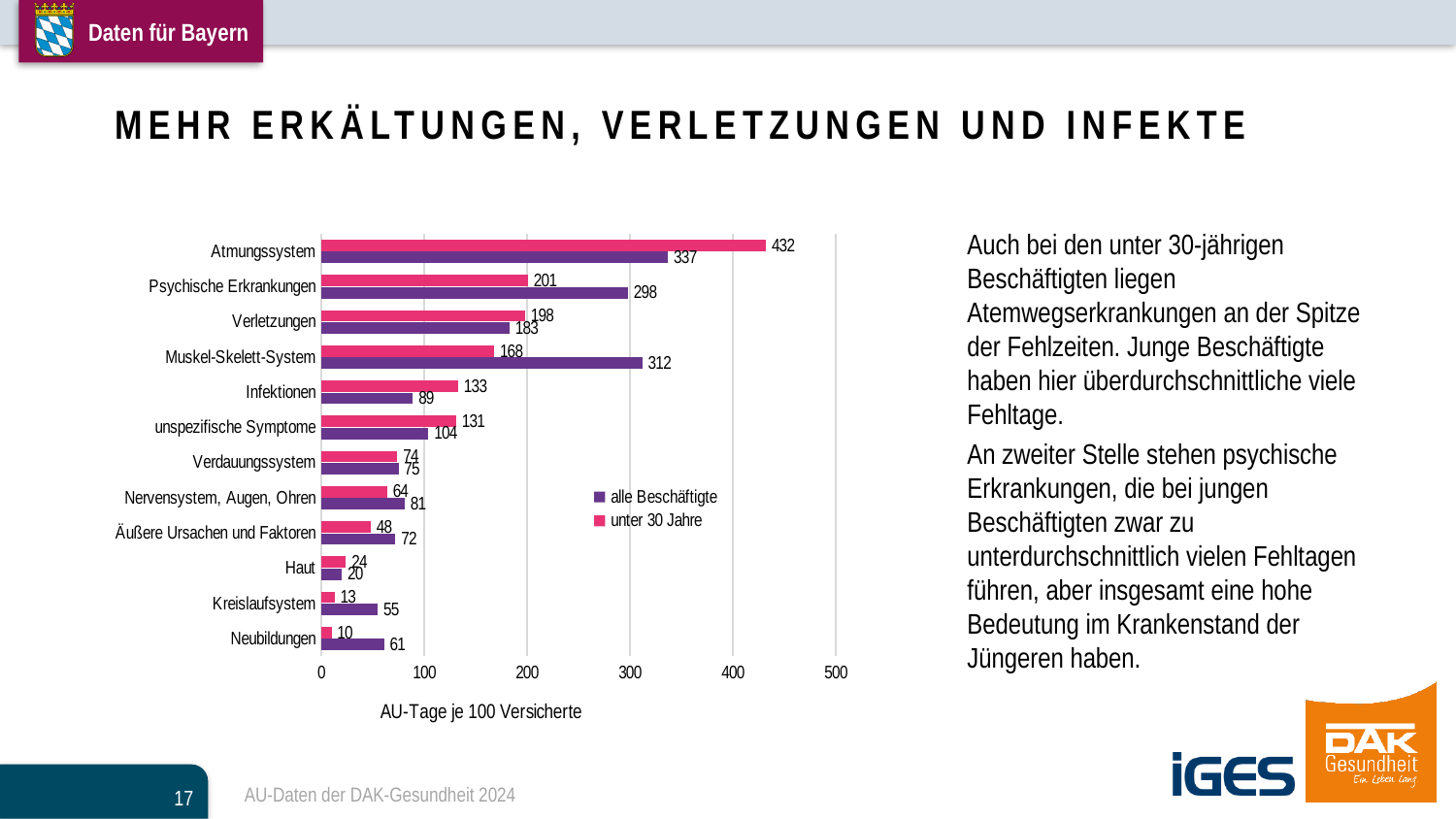
How many series does the legend list? 2 For Psychische Erkrankungen, which series has the larger value: 'alle Beschäftigte' or 'unter 30 Jahre'? alle Beschäftigte Which category has the highest value in the 'alle Beschäftigte' series? Atmungssystem Which category has the lowest value in the 'unter 30 Jahre' series? Neubildungen Is the 'alle Beschäftigte' value for Muskel-Skelett-System greater or less than 300? greater What is the value for Atmungssystem in the 'unter 30 Jahre' series? 432 What is the label of the horizontal axis of the chart? AU-Tage je 100 Versicherte What is the value for Kreislaufsystem in the 'unter 30 Jahre' series? 13 What is the difference between the 'unter 30 Jahre' and 'alle Beschäftigte' values for Atmungssystem? 95 What is the value for Muskel-Skelett-System in the 'alle Beschäftigte' series? 312 How many categories are shown on the chart? 12 What kind of chart is shown on the slide? bar chart